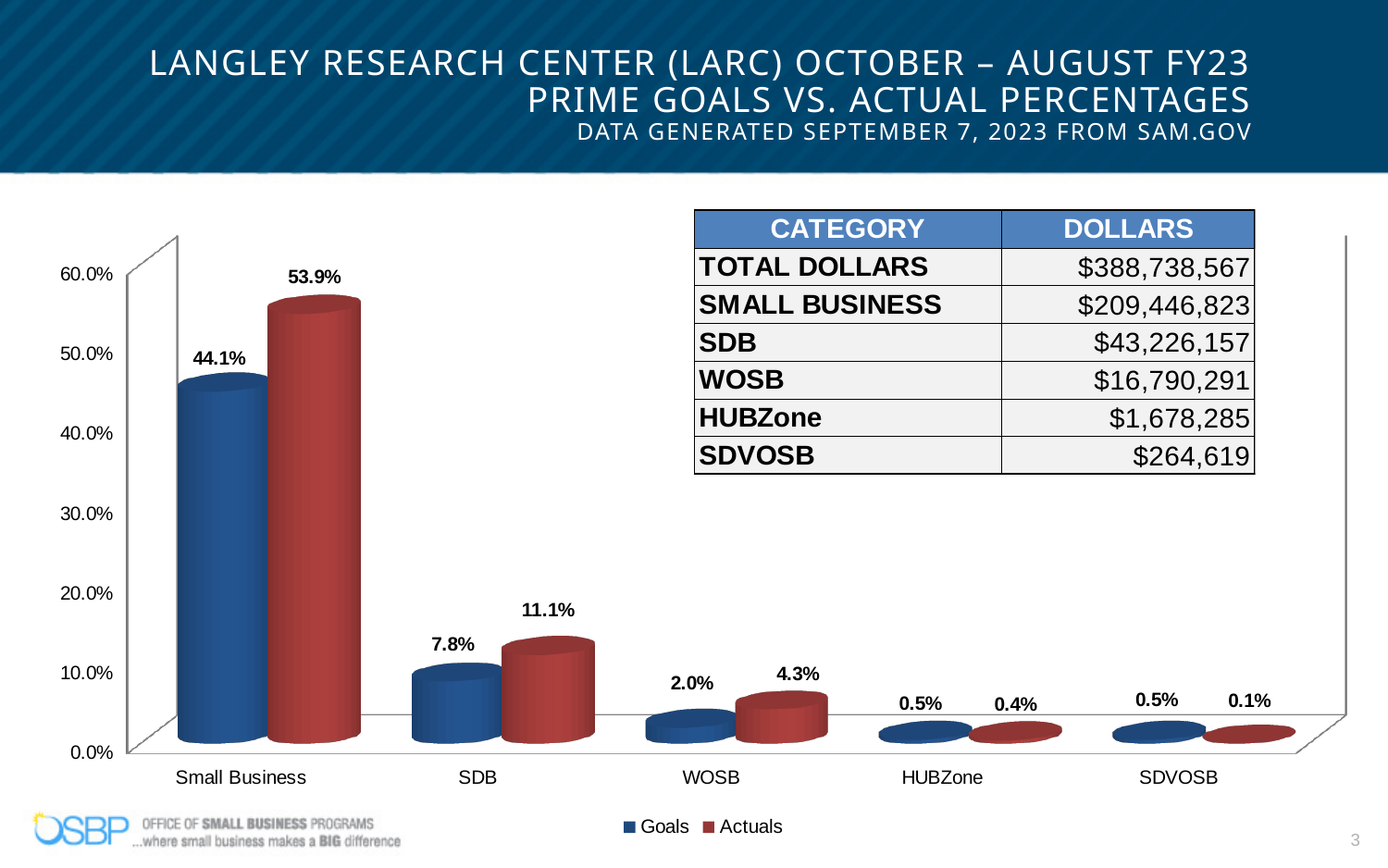
Which category has the lowest Actuals value? SDVOSB Which category has the highest Actuals value? Small Business How many series does the chart legend list? 2 For SDVOSB, which is larger: the Goals value or the Actuals value? Goals Is the Goals value for Small Business greater or less than 40.0%? greater What is the difference between the Actuals and Goals values for Small Business? 9.8% What is the Actuals value for WOSB? 4.3% What is the Actuals value for Small Business? 53.9% How many categories are shown on the x axis of the chart? 5 What is the Goals value for HUBZone? 0.5% What kind of chart is shown on the slide? bar chart What is the Goals value for SDB? 7.8%